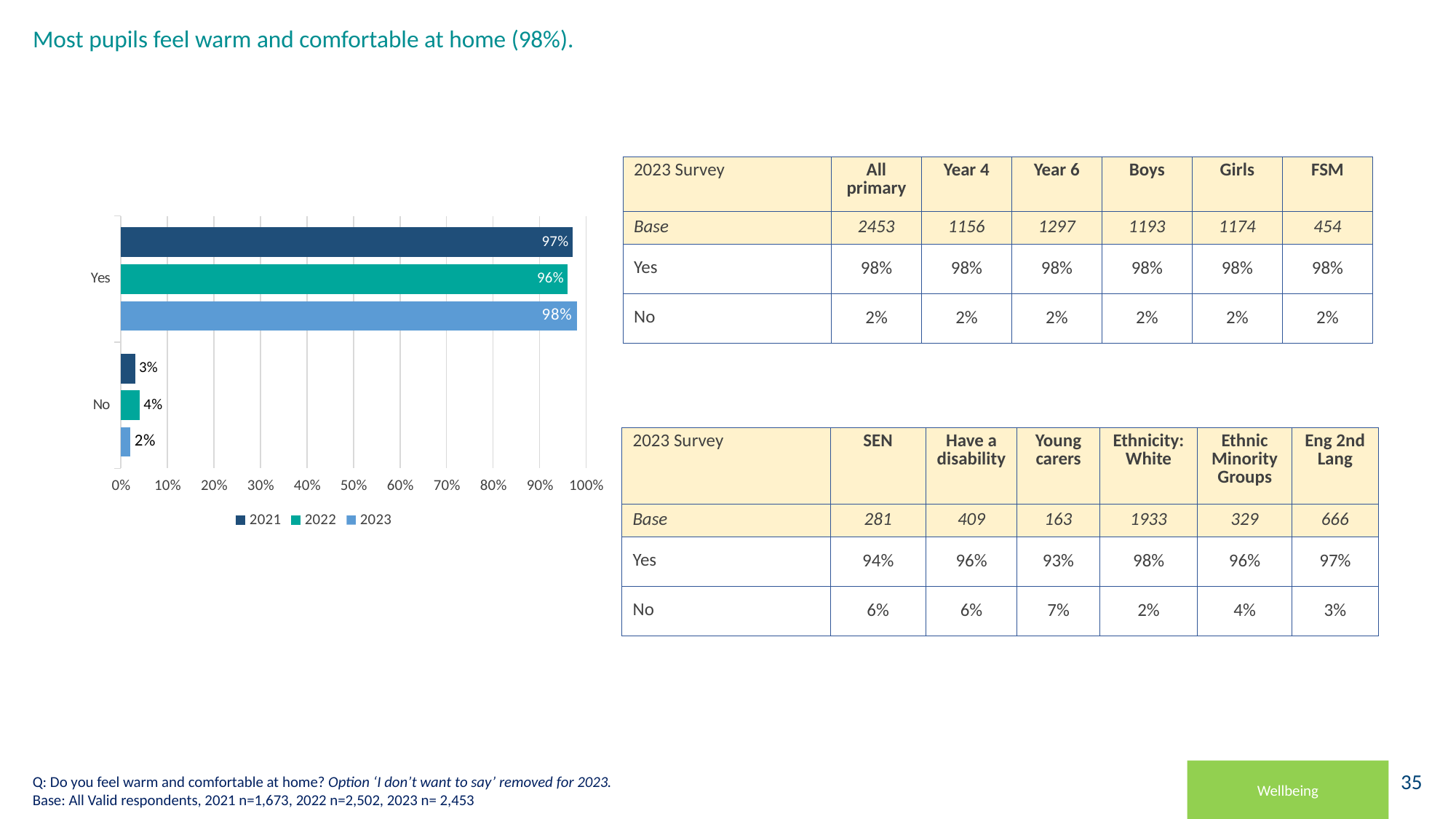
What is the difference between the Yes values for 2023 and 2022? 2% Is the value for Yes in 2022 greater or less than 90%? greater Which year has the lowest value for No? 2023 Which year has the highest value for Yes? 2023 Which is larger, the No value for 2022 or the No value for 2021? 2022 What is the value for Yes in 2021? 97% What is the value for No in 2021? 3% How many categories are shown on the chart? 2 How many series does the legend list? 3 What kind of chart is shown on the slide? bar chart What is the value for No in 2022? 4% What is the value for Yes in 2023? 98%